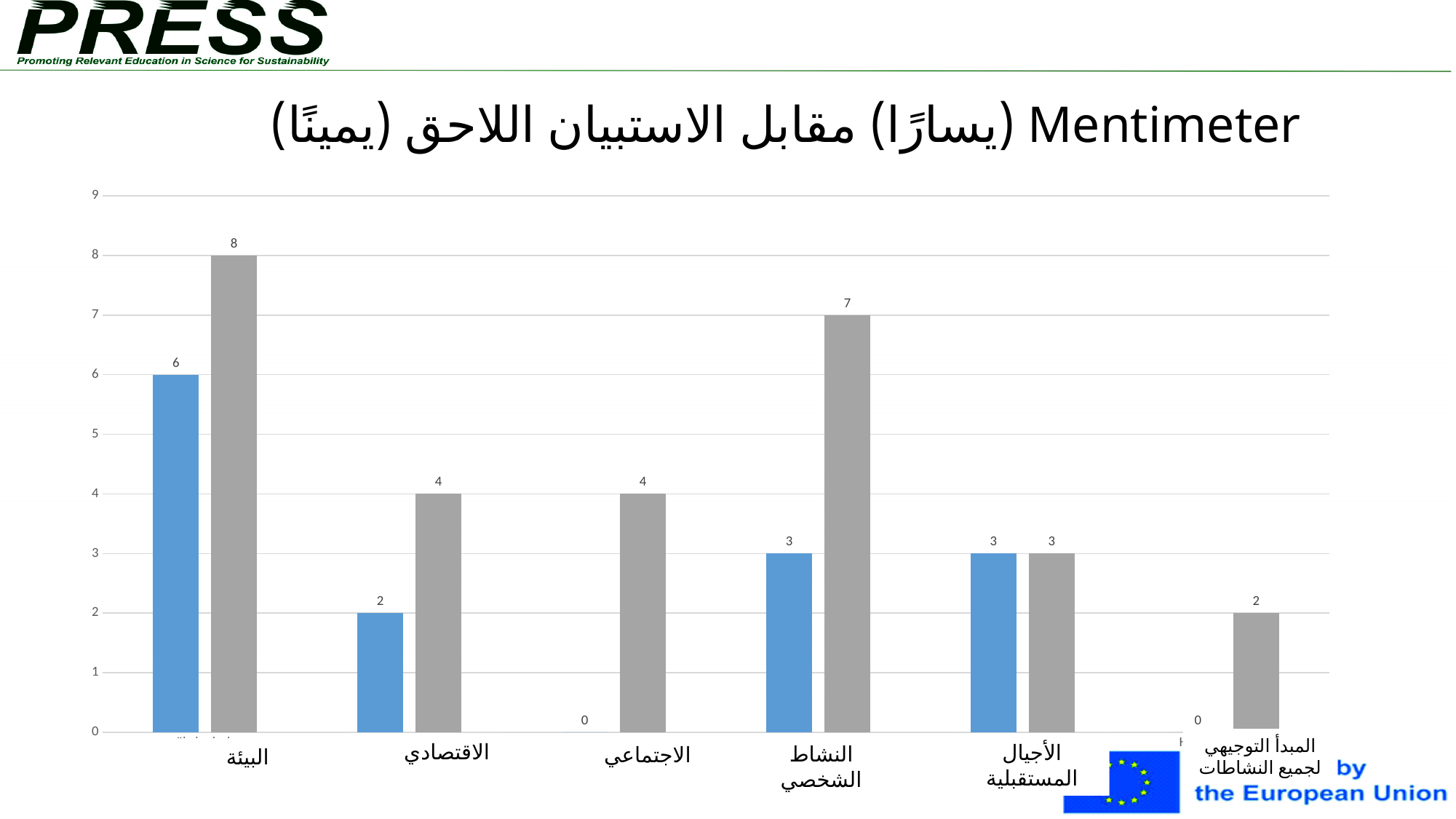
Which is larger for الاقتصادي: the Mentimeter (blue) value or the later questionnaire (gray) value? the later questionnaire (gray) value What is the Mentimeter (blue, left) value for الاجتماعي? 0 Which category has the highest Mentimeter (blue, left) value? البيئة What is the highest value shown on the vertical axis of the chart? 9 What kind of chart is shown on the slide? bar chart What is the difference between the later questionnaire (gray) and Mentimeter (blue) values for النشاط الشخصي? 4 Which category has the highest later questionnaire (gray, right) value? البيئة What is the Mentimeter (blue, left) value for البيئة? 6 What is the later questionnaire (gray, right) value for النشاط الشخصي? 7 How many categories are shown on the x axis of the chart? 6 What is the later questionnaire (gray, right) value for البيئة? 8 What is the later questionnaire (gray, right) value for المبدأ التوجيهي لجميع النشاطات? 2